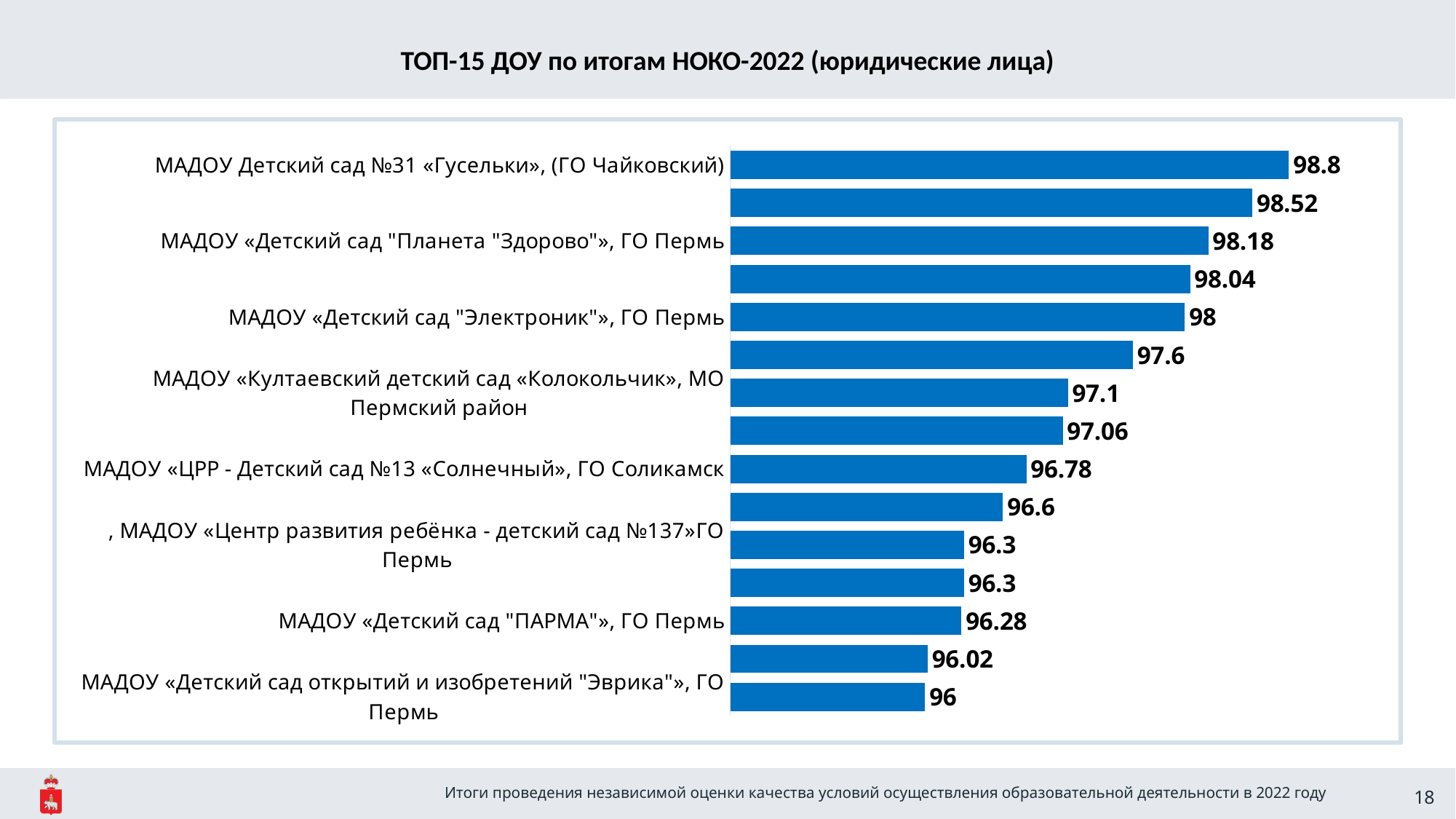
What value is shown for МАДОУ «Култаевский детский сад «Колокольчик», МО Пермский район? 97.1 What value is shown for МАДОУ «Детский сад "ПАРМА"», ГО Пермь? 96.28 Which organisation has the lowest value in the chart? МАДОУ «Детский сад открытий и изобретений "Эврика"», ГО Пермь What type of chart is shown on the slide? Bar chart What value is shown for МАДОУ Детский сад №31 «Гусельки», (ГО Чайковский)? 98.8 What value is shown for МАДОУ «Детский сад "Планета "Здорово"», ГО Пермь? 98.18 How many bars are plotted in the chart? 15 What value is shown for МАДОУ «Детский сад открытий и изобретений "Эврика"», ГО Пермь? 96 What value is shown for МАДОУ «Детский сад "Электроник"», ГО Пермь? 98 Which organisation has the highest value in the chart? МАДОУ Детский сад №31 «Гусельки», (ГО Чайковский) Which has a larger value: МАДОУ «Детский сад "Электроник"», ГО Пермь or МАДОУ «Детский сад "ПАРМА"», ГО Пермь? МАДОУ «Детский сад "Электроник"», ГО Пермь What is the difference between the highest value (98.8) and the lowest value (96) in the chart? 2.8